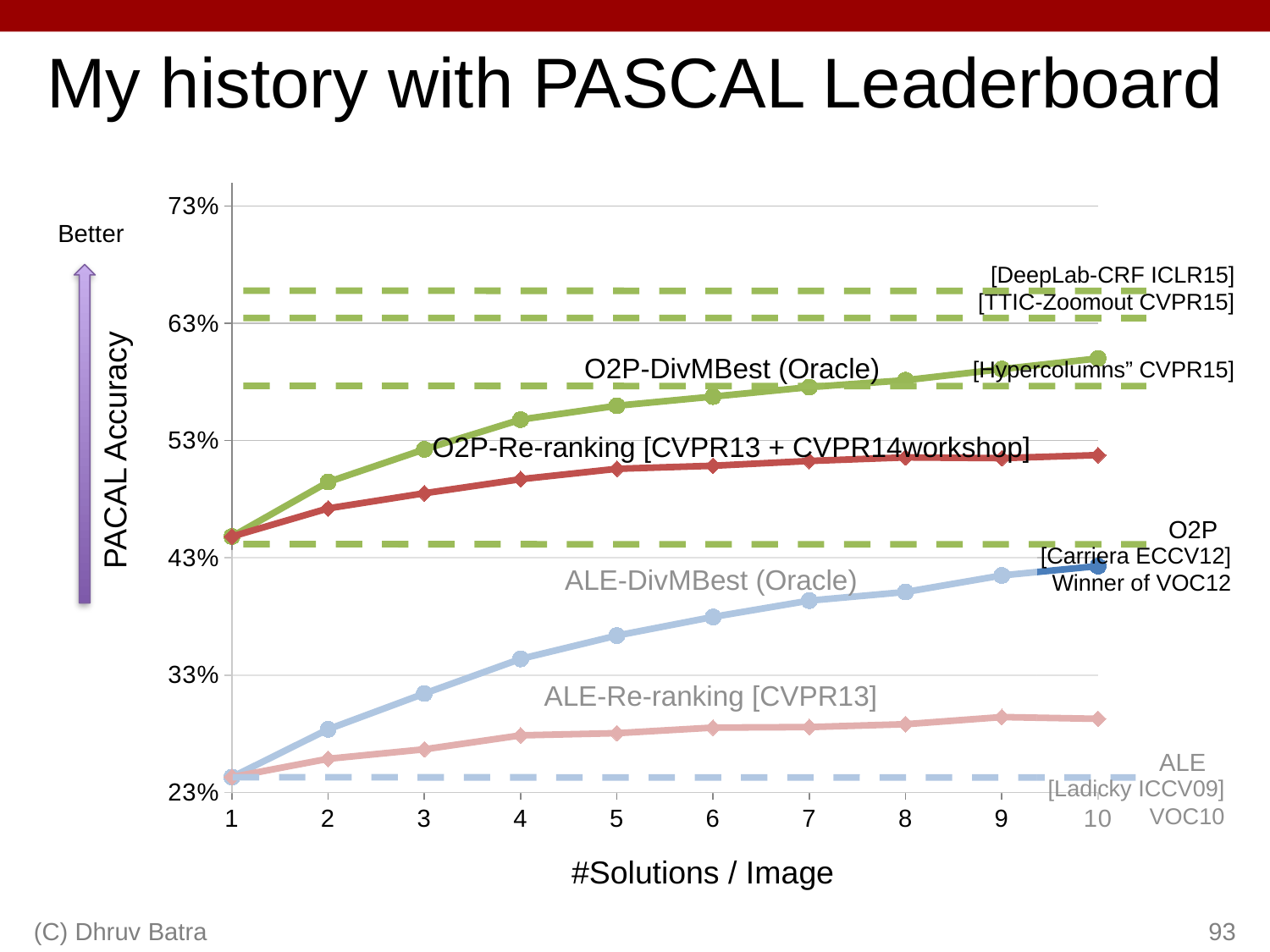
What kind of chart is shown on the slide? line chart Is the value for O2P-DivMBest (Oracle) at 10 solutions per image greater or less than 53%? greater Does the ALE-DivMBest (Oracle) line rise or fall as #Solutions / Image increases? rise At 5 solutions per image, which is larger: O2P-DivMBest (Oracle) or ALE-DivMBest (Oracle)? O2P-DivMBest (Oracle) How many points along the #Solutions / Image axis does each line have? 10 Is the value for ALE-DivMBest (Oracle) at 4 solutions per image greater or less than 43%? less What is the title of the x axis? #Solutions / Image Which line has the highest value at 10 solutions per image? O2P-DivMBest (Oracle) Which line has the lowest value at 10 solutions per image? ALE-Re-ranking [CVPR13] Is the value for ALE-Re-ranking [CVPR13] at 1 solution per image greater or less than 33%? less Does the O2P-DivMBest (Oracle) line rise or fall as #Solutions / Image increases? rise